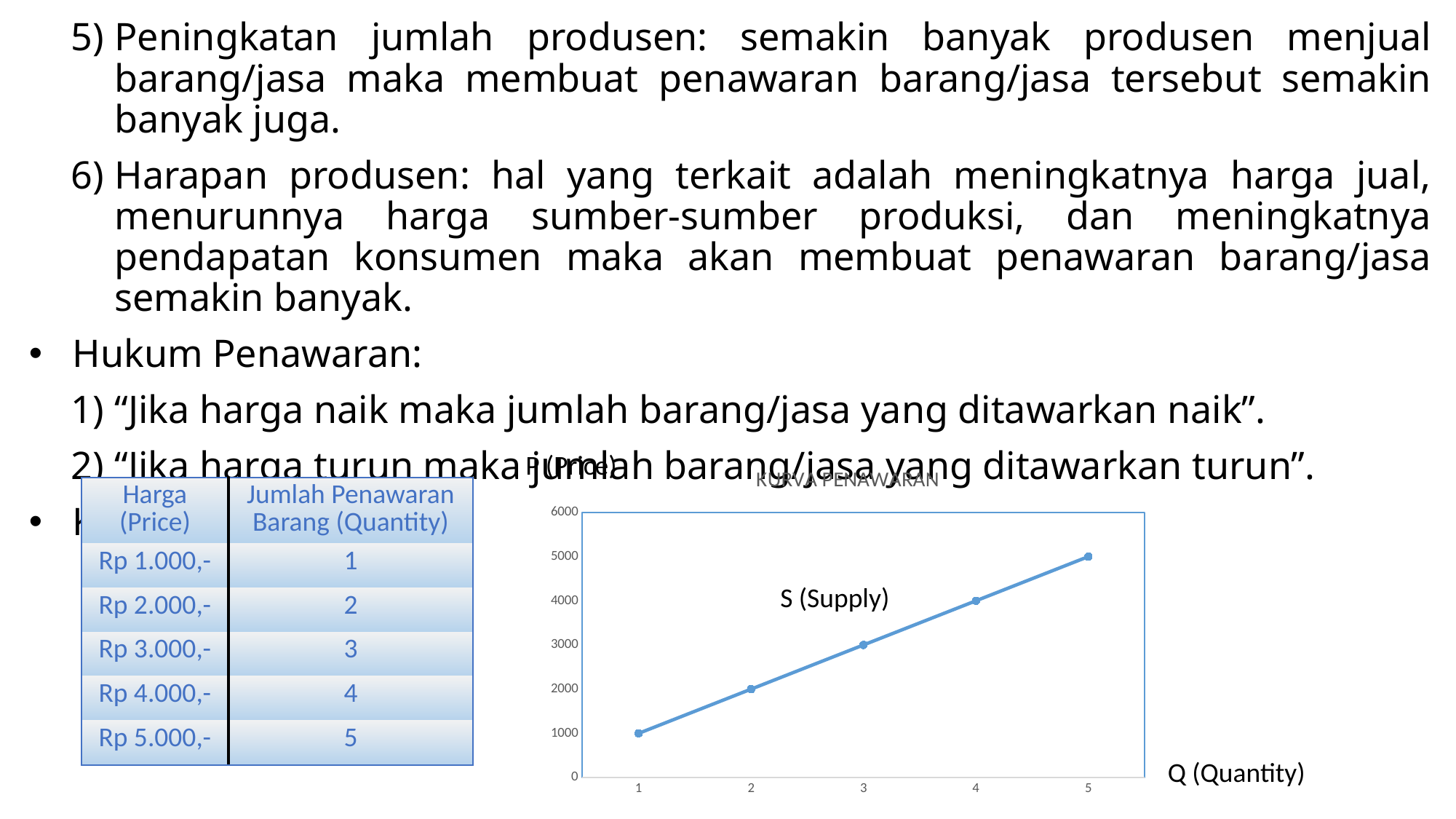
How many data points are plotted on the line chart? 5 What label is written next to the line on the chart? S (Supply) Which is larger on the line chart, the value at x = 2 or the value at x = 4? x = 4 What is the difference between the values at x = 5 and x = 1 on the line chart? 4000 What is the value plotted at x = 5 on the line chart? 5000 What is the value plotted at x = 3 on the line chart? 3000 What is the value plotted at x = 1 on the line chart? 1000 Is the value at x = 4 on the line chart greater or less than 3000? greater Do the values on the line chart rise or fall as the x axis goes from 1 to 5? rise At which x-axis category does the line chart reach its highest value? 5 At which x-axis category does the line chart have its lowest value? 1 What kind of chart is shown on the slide? line chart